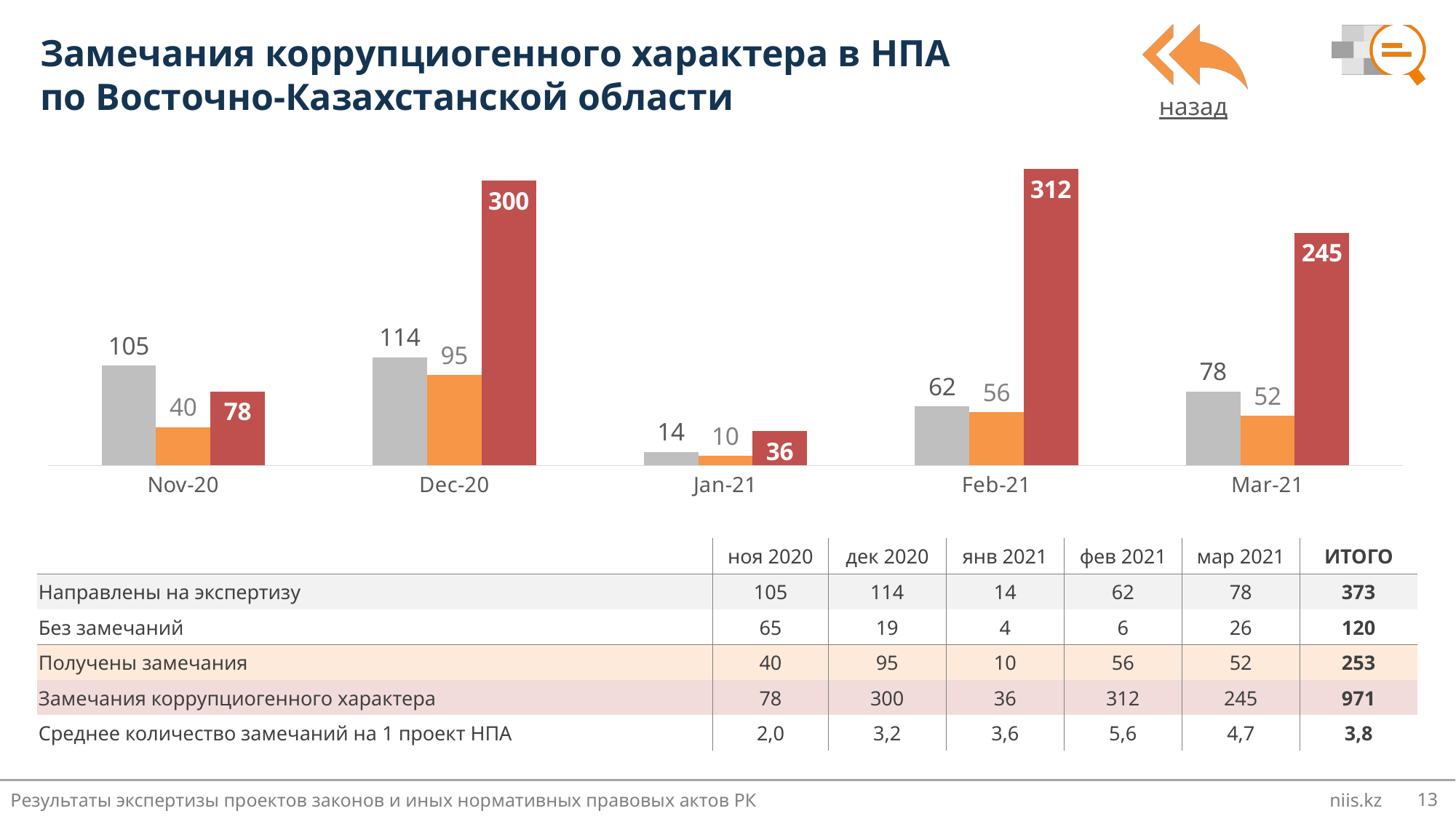
What is the value of the gray bar (Направлены на экспертизу) for Dec-20? 114 Does the red bar (Замечания коррупциогенного характера) rise or fall from Feb-21 to Mar-21? fall What is the difference between the red bar values for Dec-20 and Nov-20? 222 What is the value of the orange bar (Получены замечания) for Mar-21? 52 What type of chart is shown on the slide? bar chart In which month is the red bar (Замечания коррупциогенного характера) the highest? Feb-21 What is the total (ИТОГО) for Замечания коррупциогенного характера in the table? 971 Which is larger: the orange bar for Feb-21 or the orange bar for Mar-21? Feb-21 What is the value of the red bar (Замечания коррупциогенного характера) for Feb-21? 312 What colour are the bars representing Замечания коррупциогенного характера? red In which month is the gray bar (Направлены на экспертизу) the lowest? Jan-21 How many months (categories) are shown on the x axis of the chart? 5